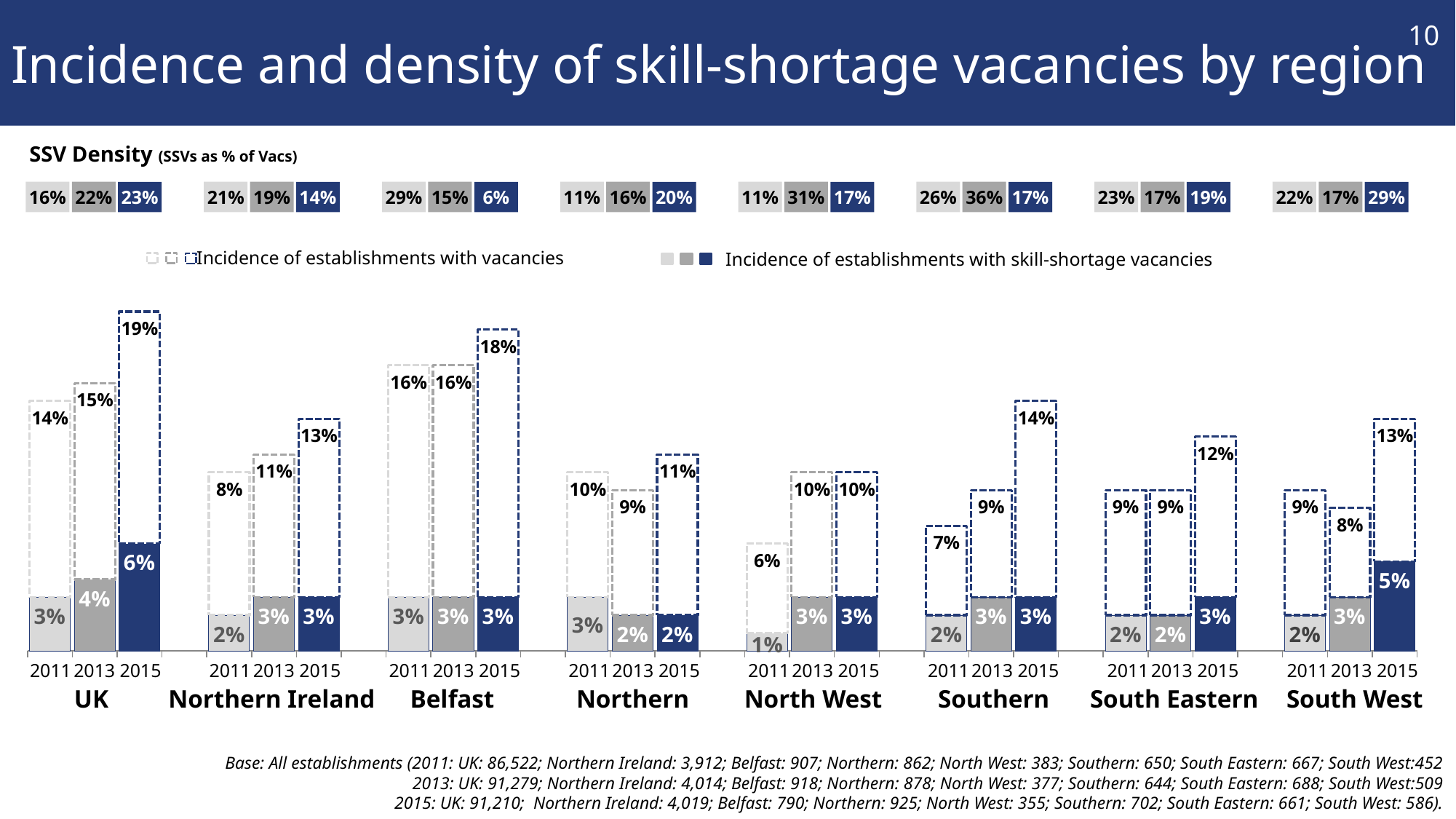
Does the incidence of establishments with vacancies in the UK rise or fall from 2011 to 2015? Rises In 2015, which has the higher incidence of establishments with vacancies, Southern or South Eastern? Southern How many series does the chart legend list? 2 What is the SSV density (SSVs as % of Vacs) for Southern in 2013? 36% Which region has the lowest incidence of establishments with skill-shortage vacancies in 2011? North West What is the incidence of establishments with vacancies in the UK in 2015? 19% How many regions are shown on the x axis of the chart? 8 What is the incidence of establishments with vacancies in Belfast in 2011? 16% What kind of chart is shown on the slide? Bar chart Which region has the highest incidence of establishments with vacancies in 2015? UK In the UK in 2015, what is the difference between the incidence of establishments with vacancies and the incidence of establishments with skill-shortage vacancies? 13 percentage points What is the incidence of establishments with skill-shortage vacancies in South West in 2015? 5%